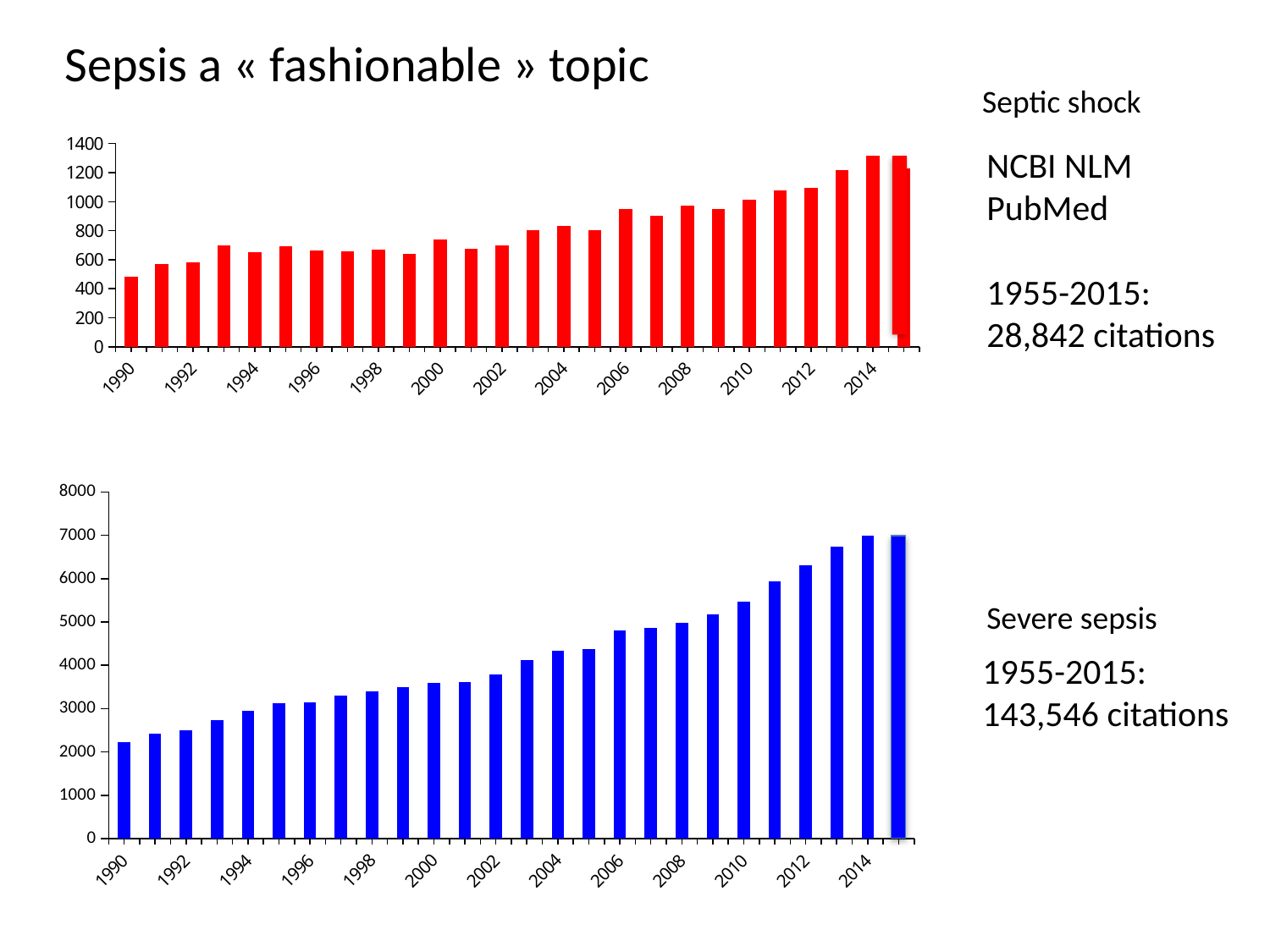
In the top chart (Septic shock), which year has the lowest value? 1990 What colour are the bars in the bottom chart (Severe sepsis)? blue In the bottom chart (Severe sepsis), is the value for 2012 greater or less than 6000? greater In the top chart (Septic shock), which is larger, the value for 2006 or the value for 2007? 2006 In the bottom chart (Severe sepsis), which year has the lowest value? 1990 In the bottom chart (Severe sepsis), do the values generally rise or fall from 1990 to 2015? rise What kind of chart is the top chart (Septic shock)? bar chart In the top chart (Septic shock), is the value for 1990 greater or less than 600? less In the top chart (Septic shock), is the value for 2014 greater or less than 1200? greater In the bottom chart (Severe sepsis), how many years are plotted along the x axis? 26